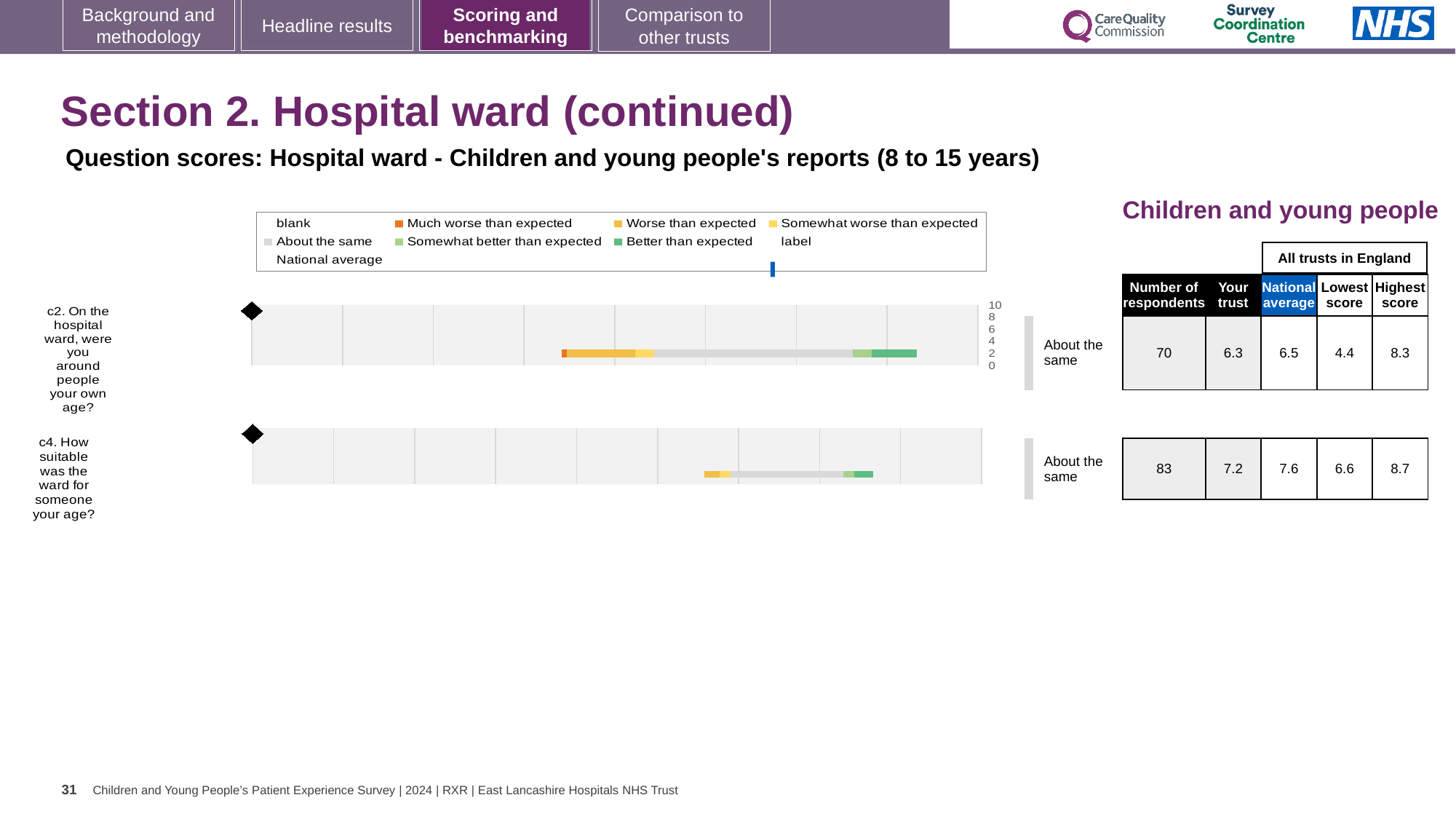
What type of chart is used to show the question scores for c2 and c4? bar chart What is the national average score for c4 (How suitable was the ward for someone your age?)? 7.6 What is the highest score among all trusts in England for c4? 8.7 What is the lowest score among all trusts in England for c4? 6.6 Which question has the higher 'Your trust' score, c2 or c4? c4 How many questions are plotted on the chart? 2 What is the 'Your trust' score for c2 (On the hospital ward, were you around people your own age?)? 6.3 How much higher is the national average than the trust's score for c4? 0.4 What is the difference between the highest and lowest scores for c2? 3.9 What benchmark category is shown for c2? About the same How many respondents answered question c2? 70